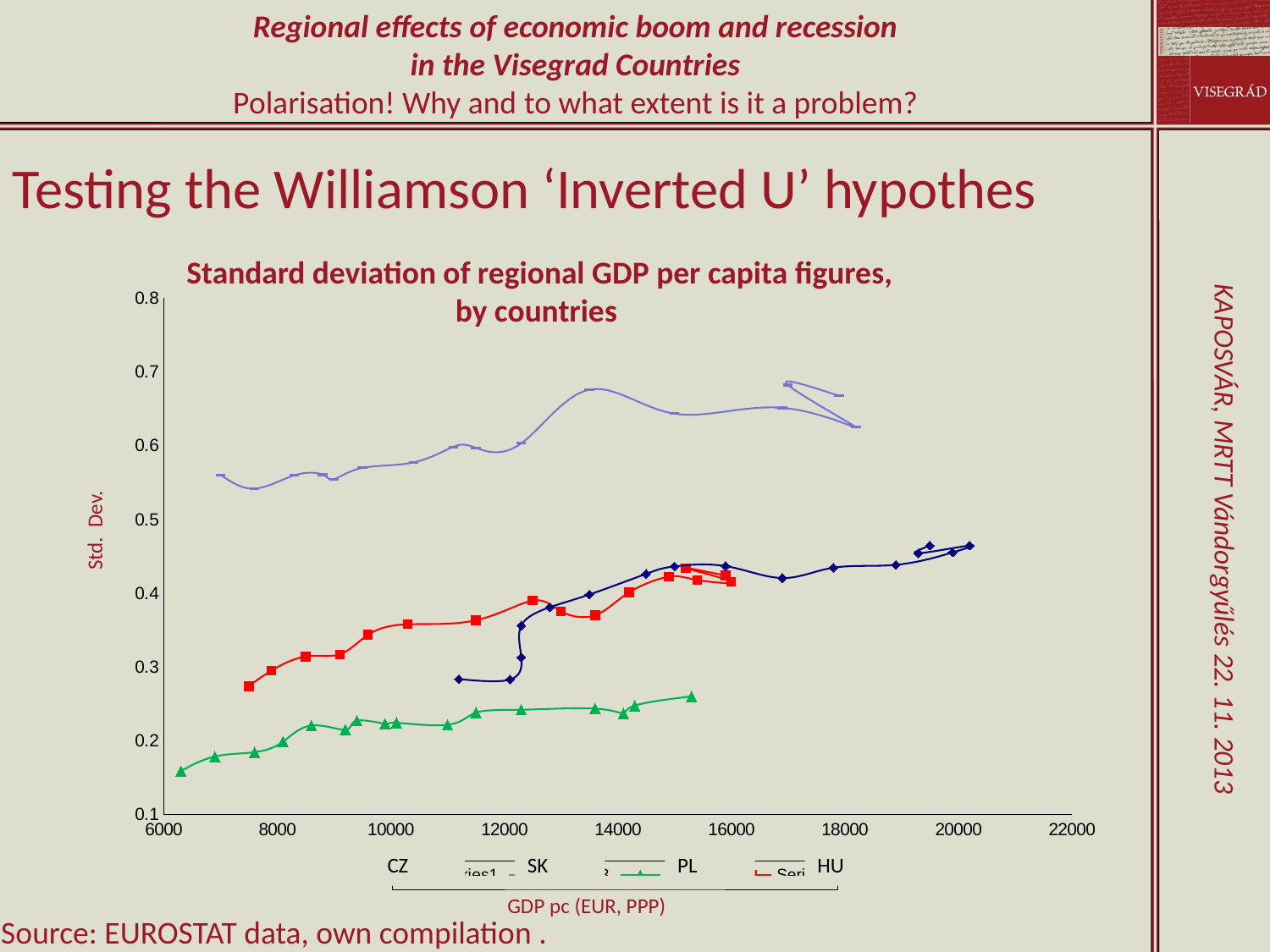
Which series has higher values, HU or PL? HU What kind of chart is shown on the slide? Line chart Which series has the highest standard deviation values across the chart? SK How many series does the chart's legend list? 4 Is the value for CZ at a GDP pc of 20000 greater or less than 0.4? greater Do the PL values generally rise or fall as GDP pc increases along the x axis? rise Is the value for PL at a GDP pc of 14000 greater or less than 0.3? less Is the value for SK at a GDP pc of 12000 greater or less than 0.5? greater Which series has the lowest standard deviation values across the chart? PL What is the title of the chart? Standard deviation of regional GDP per capita figures, by countries What is the label of the x axis of the chart? GDP pc (EUR, PPP) Which series has higher values, SK or PL? SK